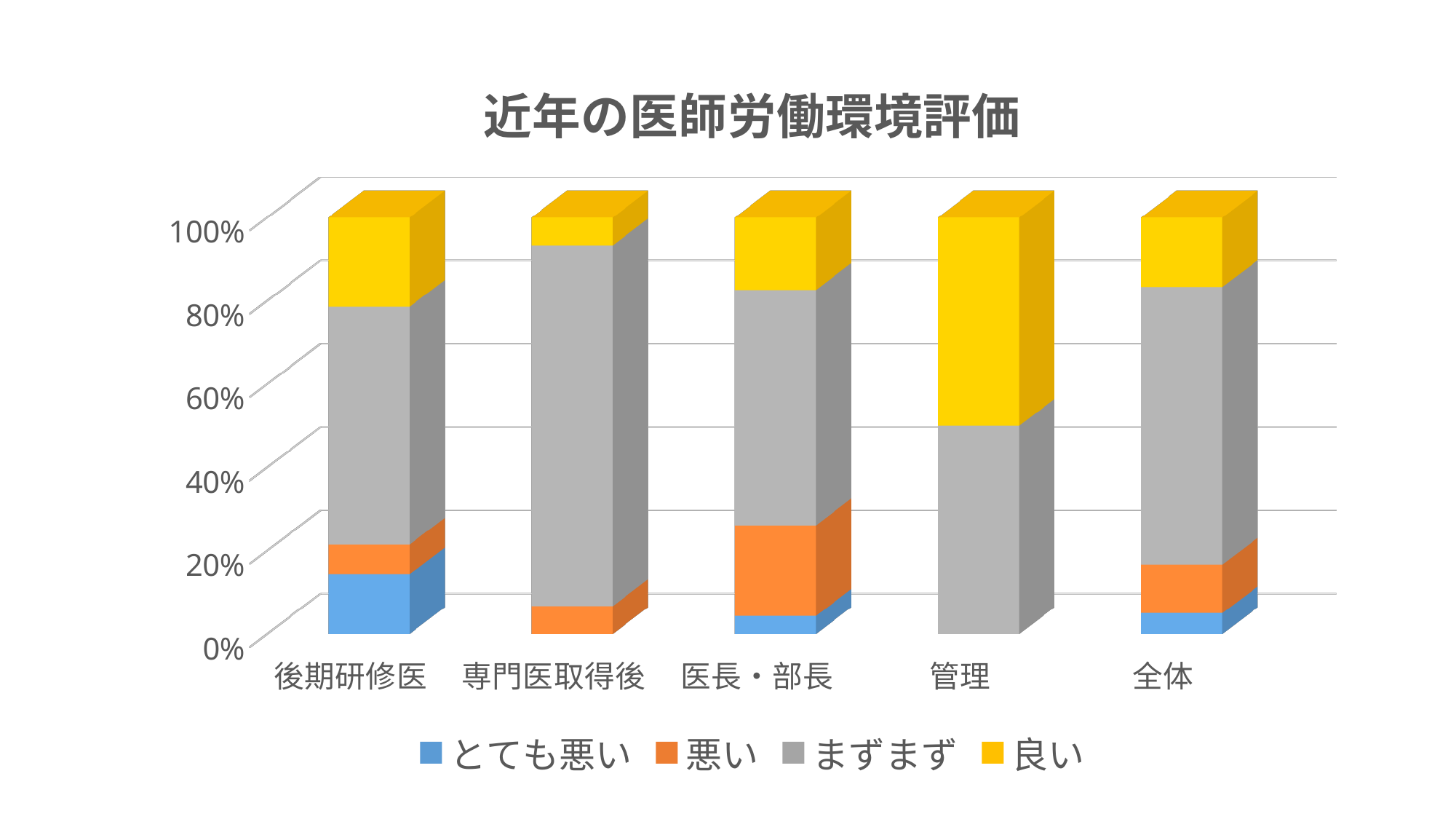
Which category has the smallest 良い segment? 専門医取得後 Which category has the largest 良い segment? 管理 What kind of chart is shown on the slide? Stacked bar chart How many categories are shown along the x axis? 5 What is the title of the chart? 近年の医師労働環境評価 Which category has the largest とても悪い segment? 後期研修医 How many series does the legend list? 4 Which category has the largest 悪い segment? 医長・部長 Which series is shown in yellow in the legend? 良い Is the 良い segment for 管理 greater or less than 40%? greater Which has a larger 良い segment, 管理 or 後期研修医? 管理